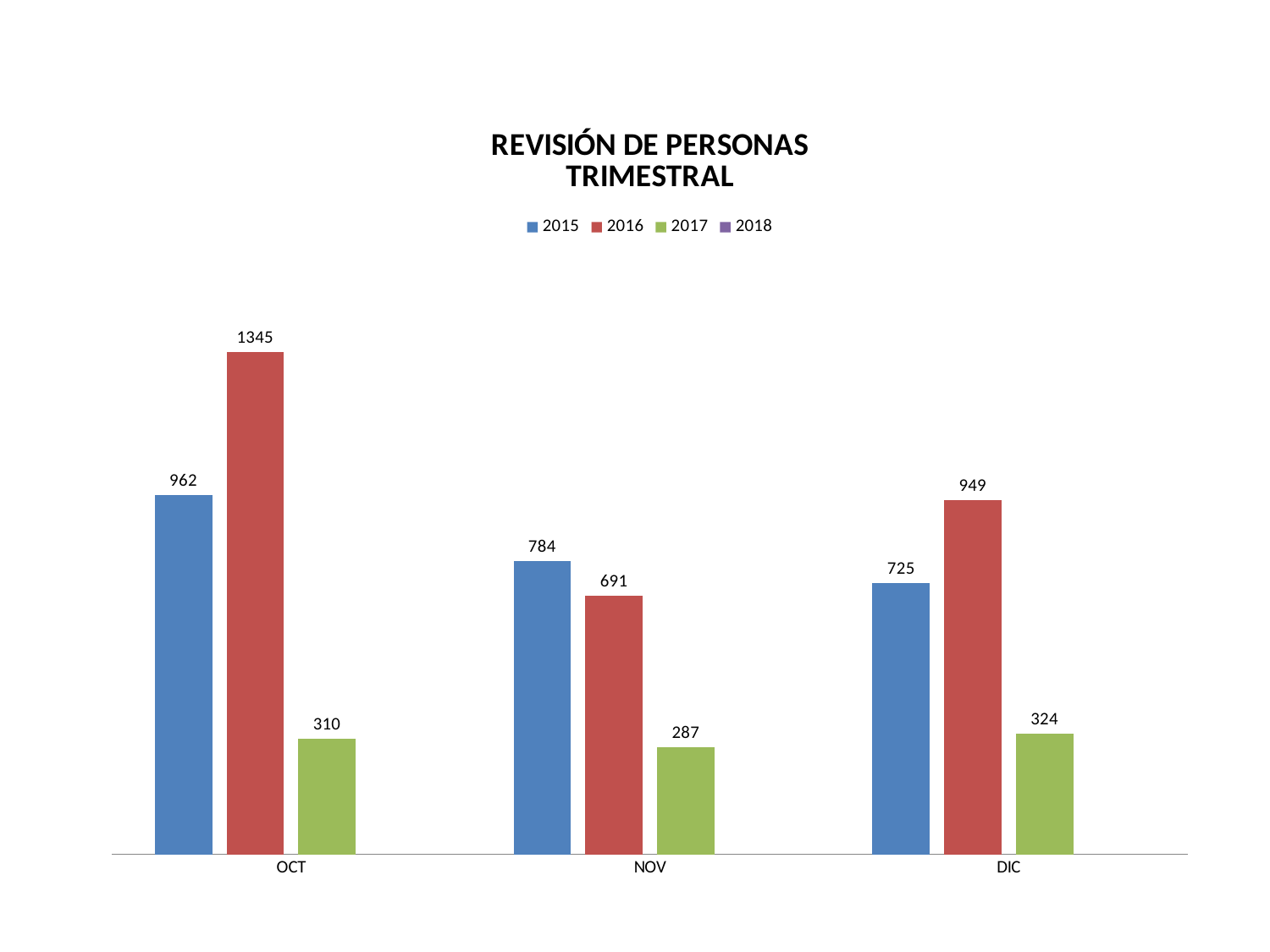
Does the 2015 series rise or fall from OCT to DIC? Fall What is the value for 2017 in DIC? 324 Which month has the lowest value for the 2017 series? NOV How many series does the legend list? 4 Which month has the highest value for the 2016 series? OCT What is the value for 2016 in OCT? 1345 Which is larger in NOV, the 2015 value or the 2016 value? 2015 What kind of chart is shown on the slide? Bar chart How many months are shown on the x axis? 3 What is the difference between the 2016 and 2015 values in OCT? 383 What is the value for 2015 in NOV? 784 What is the title of the chart? REVISIÓN DE PERSONAS TRIMESTRAL